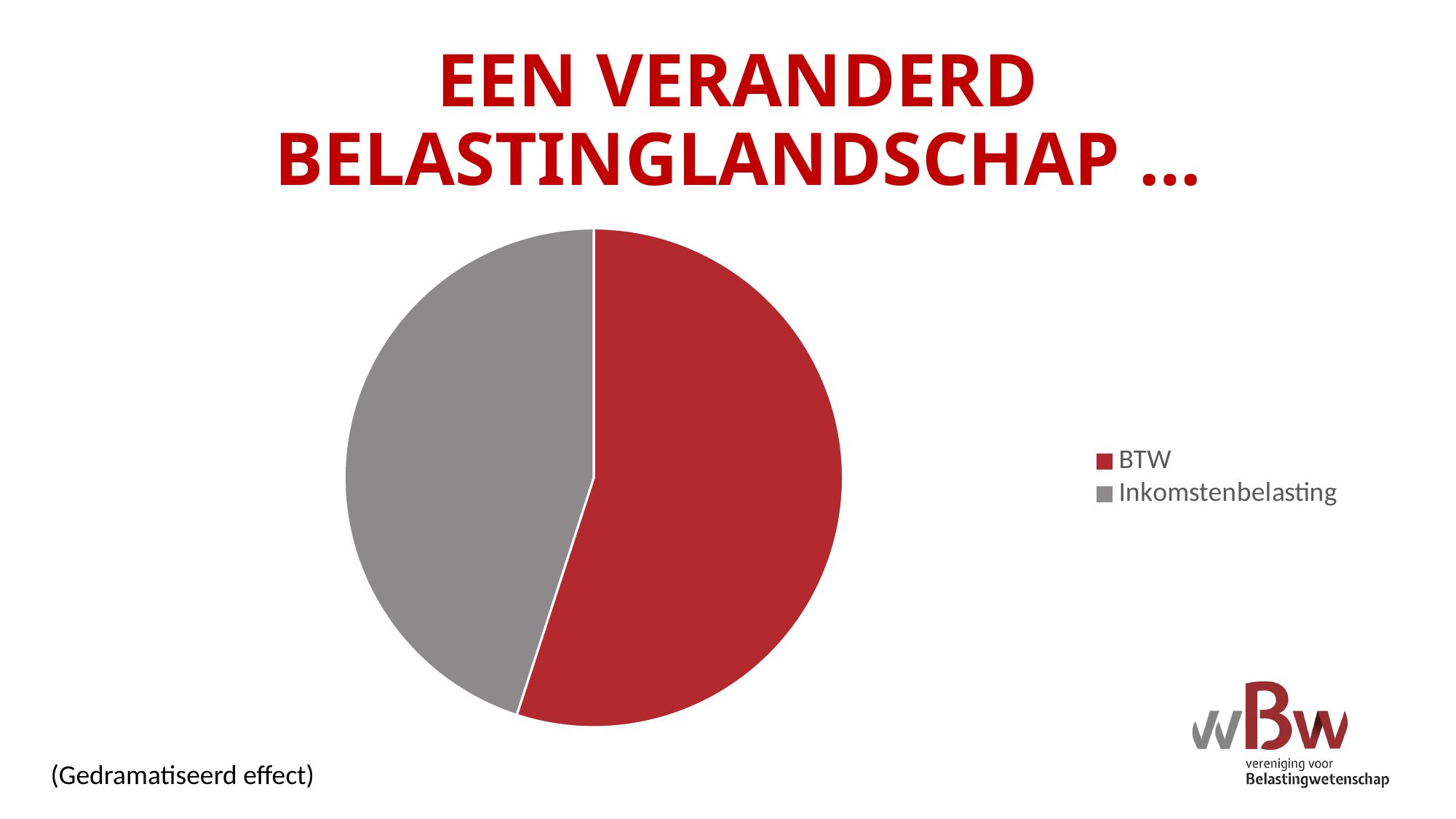
Which slice of the pie chart is the smallest? Inkomstenbelasting Which slice is larger in the pie chart, BTW or Inkomstenbelasting? BTW How many slices does the pie chart have? 2 Which category is shown in grey in the pie chart? Inkomstenbelasting What kind of chart is shown on the slide? pie chart What colour is the BTW slice in the pie chart? red How many entries does the legend of the pie chart list? 2 Which slice of the pie chart is the largest? BTW